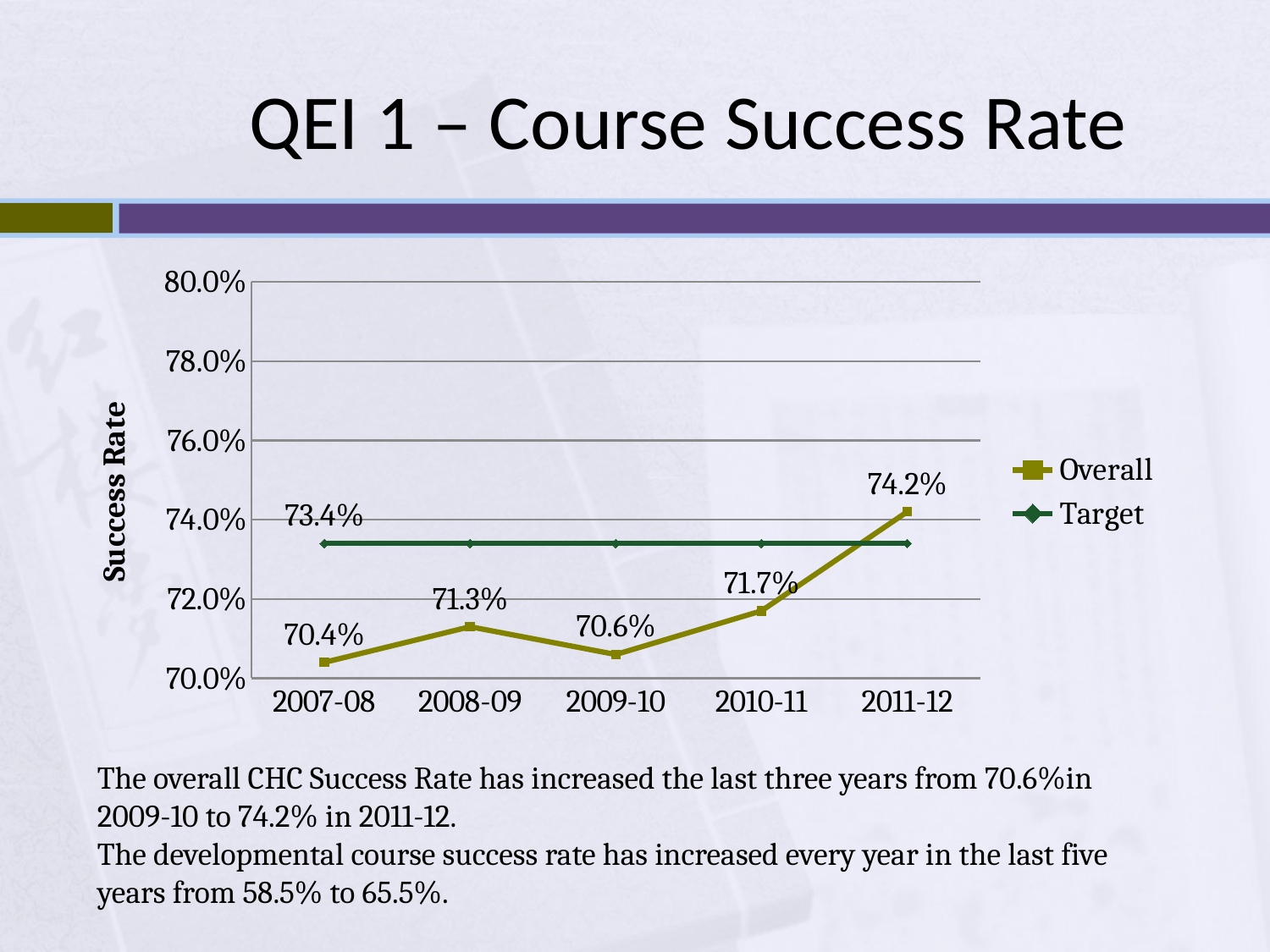
In which year is the Overall success rate highest? 2011-12 In which year is the Overall success rate lowest? 2007-08 What is the Overall success rate for 2007-08? 70.4% How many series does the legend list? 2 What is the Overall success rate for 2011-12? 74.2% How many academic years are plotted on the x axis? 5 What is the label on the vertical axis? Success Rate What kind of chart is shown on the slide? line chart What is the difference between the Overall success rate in 2011-12 and in 2010-11? 2.5% What is the Target success rate shown on the chart? 73.4% Is the Overall success rate for 2010-11 greater or less than 72.0%? less Which is larger, the Overall success rate in 2008-09 or in 2009-10? 2008-09